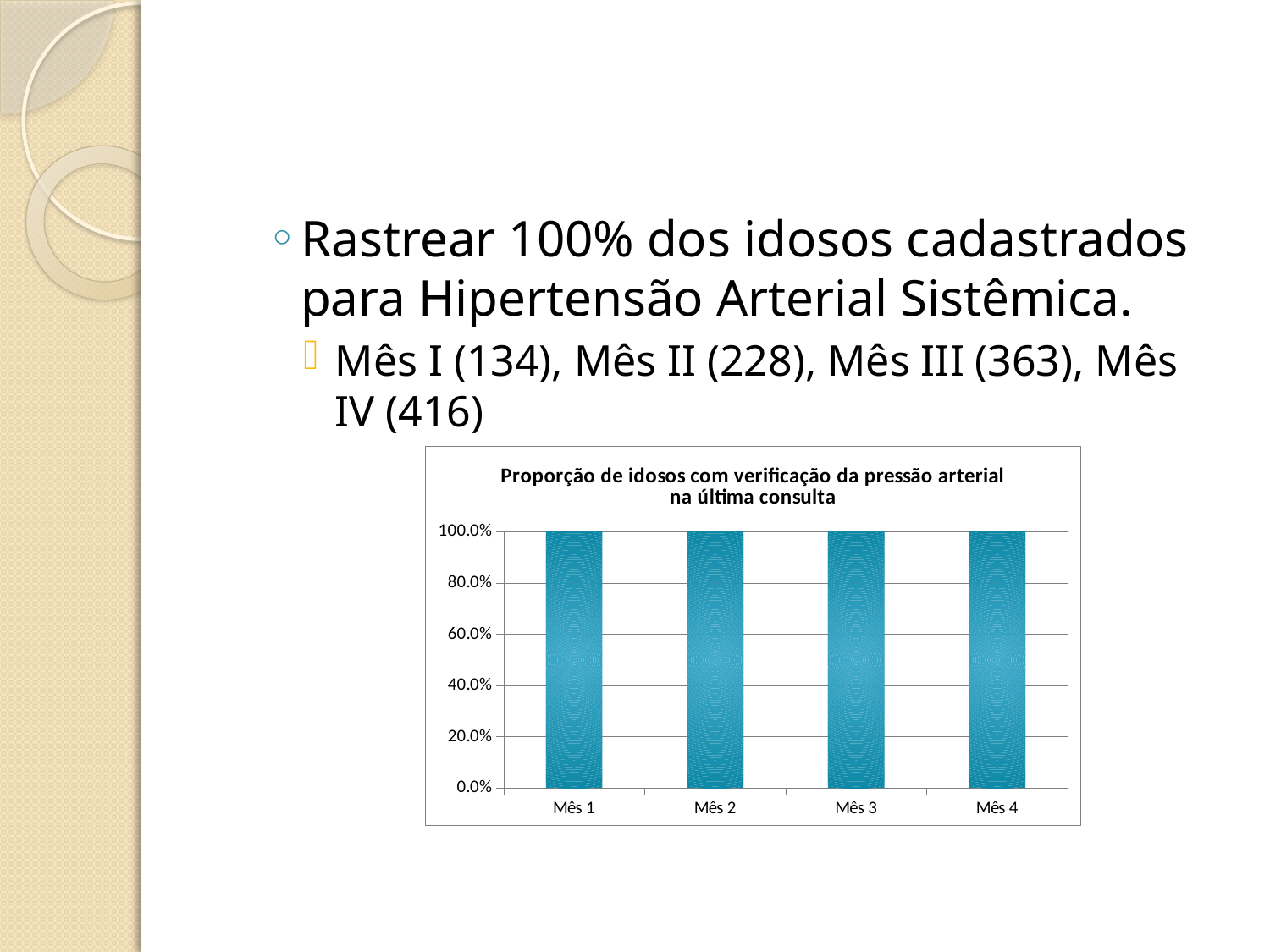
What kind of chart is shown on the slide? bar chart Is the value for Mês 1 greater or less than 60.0%? greater Is the value for Mês 3 greater or less than 80.0%? greater What is the difference between the values for Mês 4 and Mês 1? 0.0% Do the values rise, fall, or stay the same from Mês 1 to Mês 4? stay the same What is the value for Mês 3 in the chart? 100.0% What is the highest value shown on the chart's y axis? 100.0% How many categories (months) are plotted on the x axis of the chart? 4 What is the title of the chart? Proporção de idosos com verificação da pressão arterial na última consulta What is the value for Mês 1 in the chart? 100.0% What is the value for Mês 2 in the chart? 100.0% What is the value for Mês 4 in the chart? 100.0%